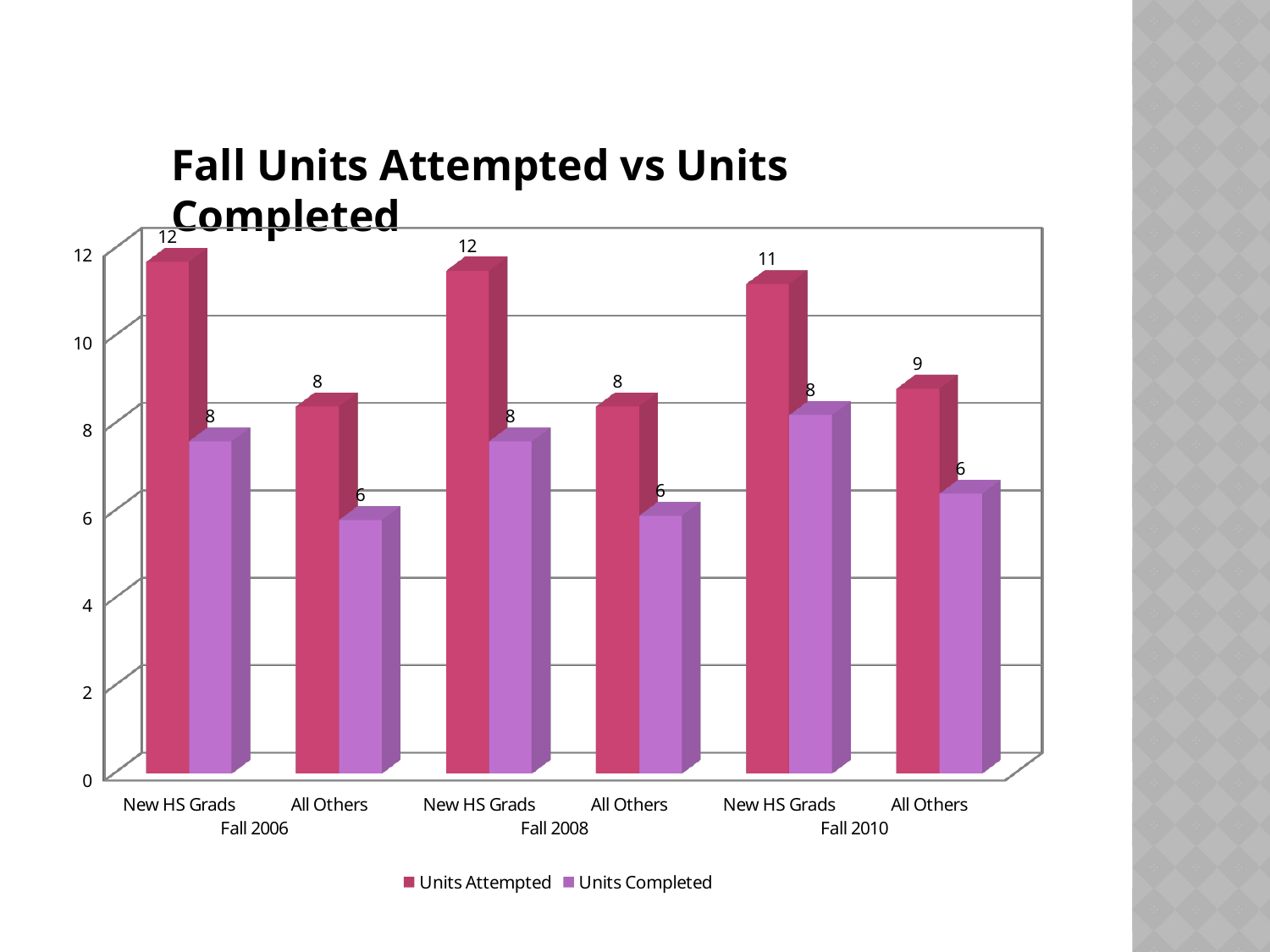
Which is larger: Units Attempted for New HS Grads in Fall 2010 or Units Attempted for All Others in Fall 2010? New HS Grads in Fall 2010 What is the value of Units Completed for New HS Grads in Fall 2008? 8 What is the value of Units Attempted for New HS Grads in Fall 2006? 12 How many series does the legend list? 2 Which category has the lowest Units Attempted value? All Others, Fall 2006 and Fall 2008 (8) What is the difference between Units Attempted and Units Completed for New HS Grads in Fall 2006? 4 What kind of chart is shown on the slide? Bar chart What is the title of the chart? Fall Units Attempted vs Units Completed What is the value of Units Completed for All Others in Fall 2010? 6 What is the value of Units Attempted for New HS Grads in Fall 2010? 11 How many categories are shown on the x axis? 6 What is the difference between Units Attempted and Units Completed for All Others in Fall 2010? 3